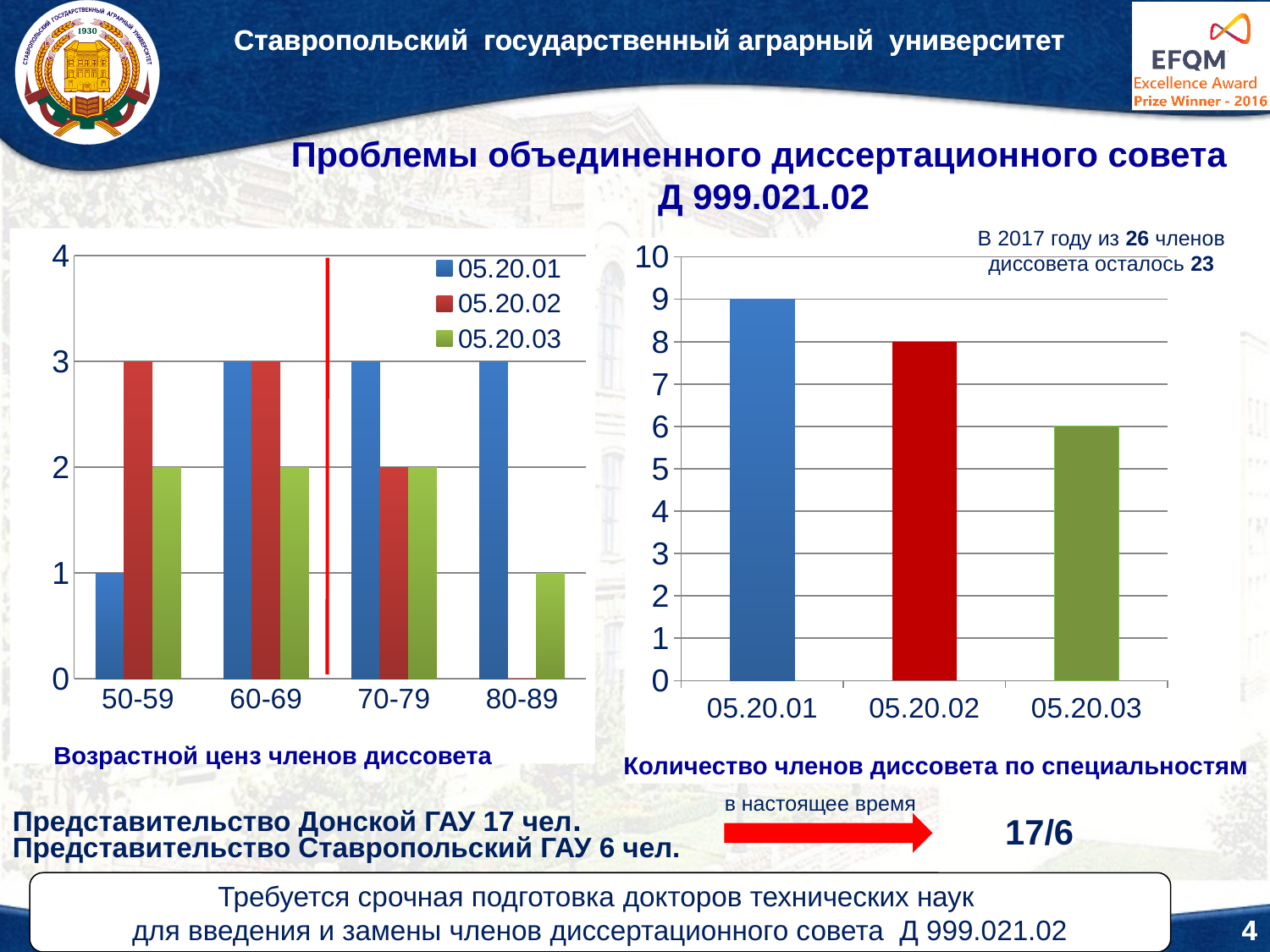
What type of chart is 'Возрастной ценз членов диссовета'? bar chart In the chart 'Количество членов диссовета по специальностям', is the value for 05.20.02 greater or less than 5? greater In the chart 'Возрастной ценз членов диссовета', how many age categories are shown on the x axis? 4 In the chart 'Возрастной ценз членов диссовета', what is the value of series 05.20.03 for the 80-89 category? 1 In the chart 'Количество членов диссовета по специальностям', what is the difference between the values for 05.20.01 and 05.20.03? 3 In the chart 'Количество членов диссовета по специальностям', which specialty has the lowest value? 05.20.03 In the chart 'Количество членов диссовета по специальностям', what is the value for 05.20.01? 9 In the chart 'Количество членов диссовета по специальностям', how many bars are plotted? 3 In the chart 'Возрастной ценз членов диссовета', what is the value of series 05.20.01 for the 50-59 category? 1 In the chart 'Возрастной ценз членов диссовета', which is larger for the 70-79 category: series 05.20.01 or series 05.20.02? 05.20.01 In the chart 'Возрастной ценз членов диссовета', how many series does the legend list? 3 In the chart 'Количество членов диссовета по специальностям', what is the value for 05.20.03? 6